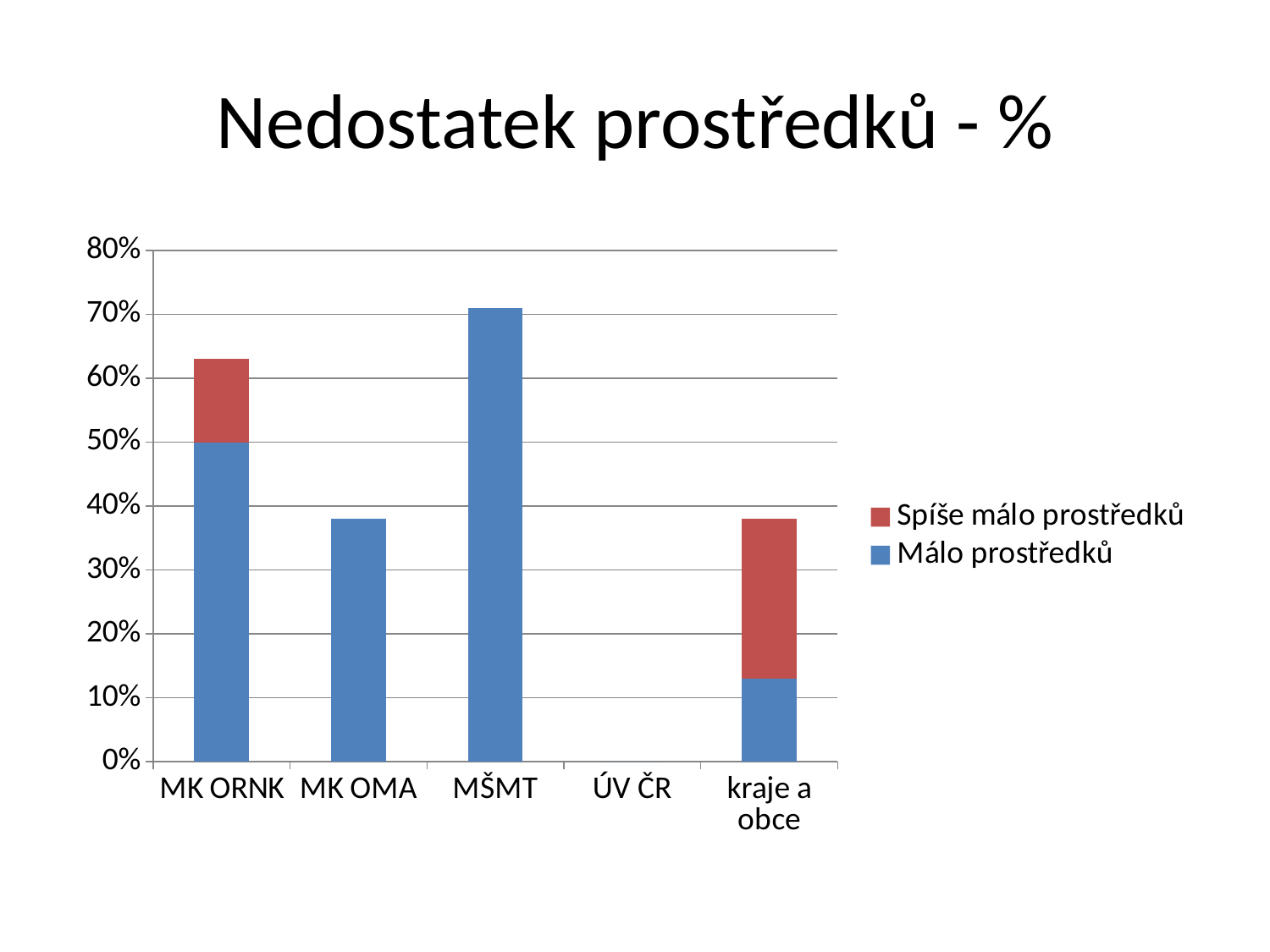
Which category has the tallest bar overall? MŠMT Is the total bar for MŠMT greater or less than 60%? greater Is the value for MK OMA greater or less than 40%? less What is the title of the chart? Nedostatek prostředků - % Is the 'Málo prostředků' value for kraje a obce greater or less than 20%? less Which colour represents 'Spíše málo prostředků' in the legend? red Which has the taller total bar, MK ORNK or MK OMA? MK ORNK Which category has no visible bar at all? ÚV ČR How many series does the legend list? 2 What kind of chart is shown on the slide? bar chart How many categories are shown on the x axis? 5